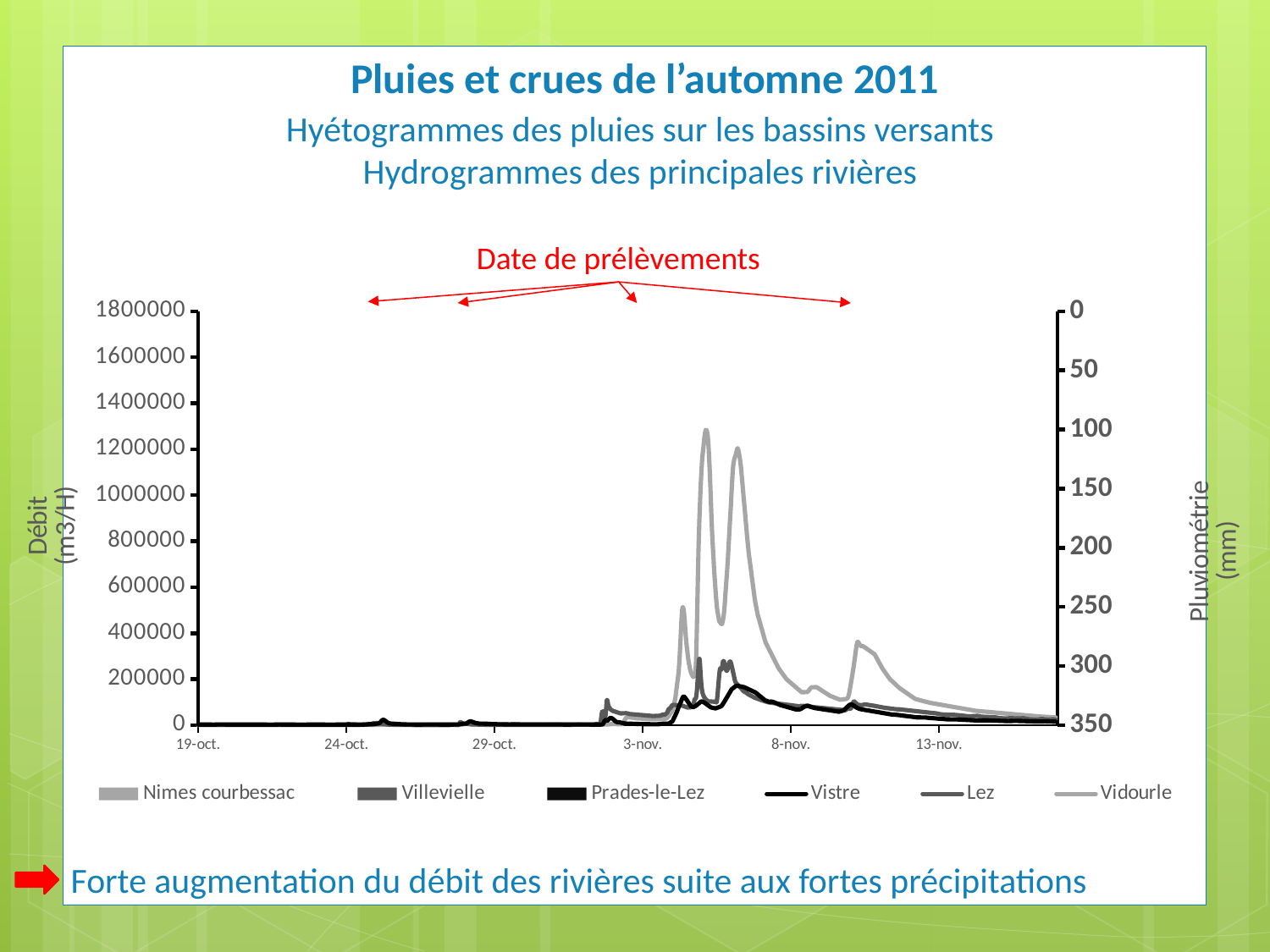
What is the title of the chart on the slide? Pluies et crues de l'automne 2011 What is the first date label on the x axis? 19-oct. What is the label of the left vertical axis? Débit (m3/H) Is the highest peak of the Vidourle series greater or less than 1000000 m3/H? greater Is the highest peak of the Vistre series greater or less than 400000 m3/H? less What is the maximum value shown on the left vertical axis? 1800000 How many date labels are shown on the x axis? 6 What is the maximum value shown on the right vertical axis (Pluviométrie)? 350 How many series does the chart legend list? 6 What kind of chart is used to plot the river flow series (Vistre, Lez, Vidourle)? line chart Which series has a higher peak flow, Vidourle or Vistre? Vidourle Which series reaches the highest peak flow on the chart? Vidourle